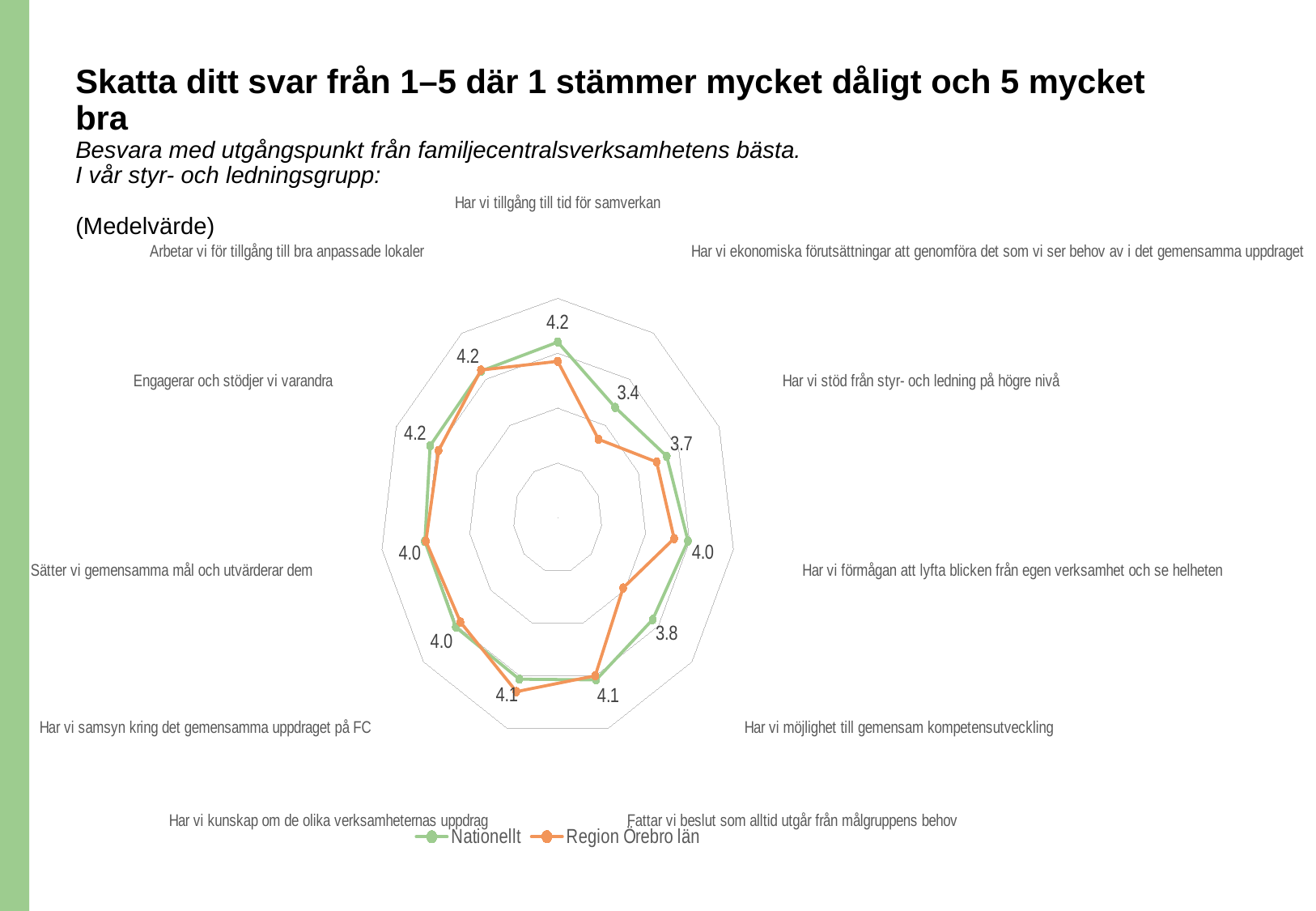
What is the Nationellt value for 'Har vi tillgång till tid för samverkan'? 4.2 How many series does the legend list? 2 Which category has the lowest Nationellt value? Har vi ekonomiska förutsättningar att genomföra det som vi ser behov av i det gemensamma uppdraget Which colour is used for the Region Örebro län series? Orange What kind of chart is shown on the slide? Radar chart What is the Nationellt value for 'Har vi möjlighet till gemensam kompetensutveckling'? 3.8 What is the Nationellt value for 'Har vi stöd från styr- och ledning på högre nivå'? 3.7 For 'Har vi stöd från styr- och ledning på högre nivå', which series has the larger value, Nationellt or Region Örebro län? Nationellt Which two series are listed in the legend? Nationellt and Region Örebro län What is the Nationellt value for 'Har vi ekonomiska förutsättningar att genomföra det som vi ser behov av i det gemensamma uppdraget'? 3.4 What is the difference between the Nationellt values for 'Har vi tillgång till tid för samverkan' and 'Har vi ekonomiska förutsättningar att genomföra det som vi ser behov av i det gemensamma uppdraget'? 0.8 How many categories (questions) are plotted around the radar chart? 11